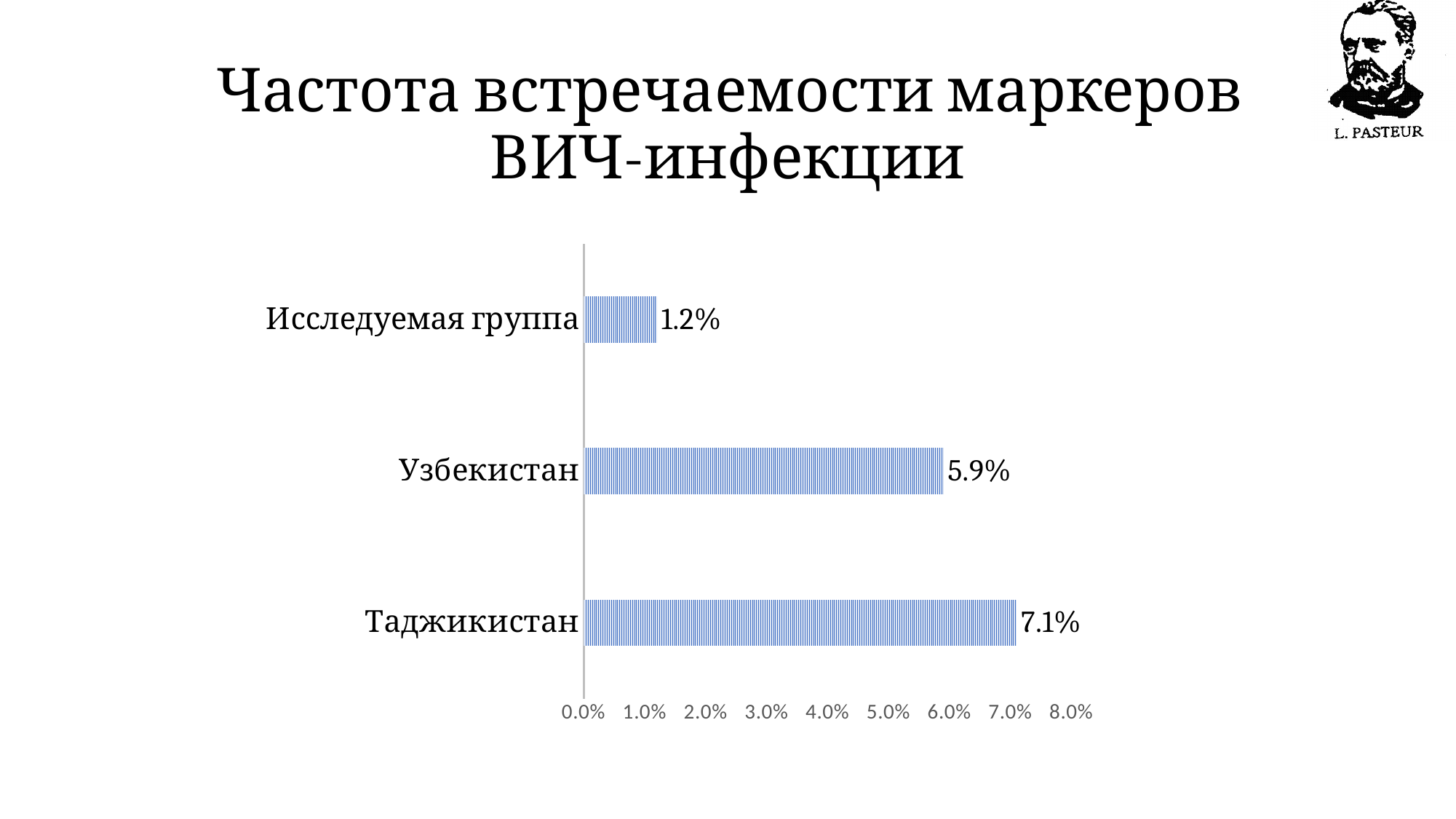
Which is larger, the value for Узбекистан or the value for Исследуемая группа? Узбекистан What kind of chart is shown on the slide? bar chart What is the value for Узбекистан? 5.9% Which category has the highest value? Таджикистан How many categories are shown in the chart? 3 Is the value for Узбекистан greater or less than 5.0%? greater What is the difference between the values for Таджикистан and Узбекистан? 1.2% What is the value for Исследуемая группа? 1.2% What is the value for Таджикистан? 7.1% Which category has the lowest value? Исследуемая группа What is the title of the slide? Частота встречаемости маркеров ВИЧ-инфекции What is the difference between the values for Узбекистан and Исследуемая группа? 4.7%